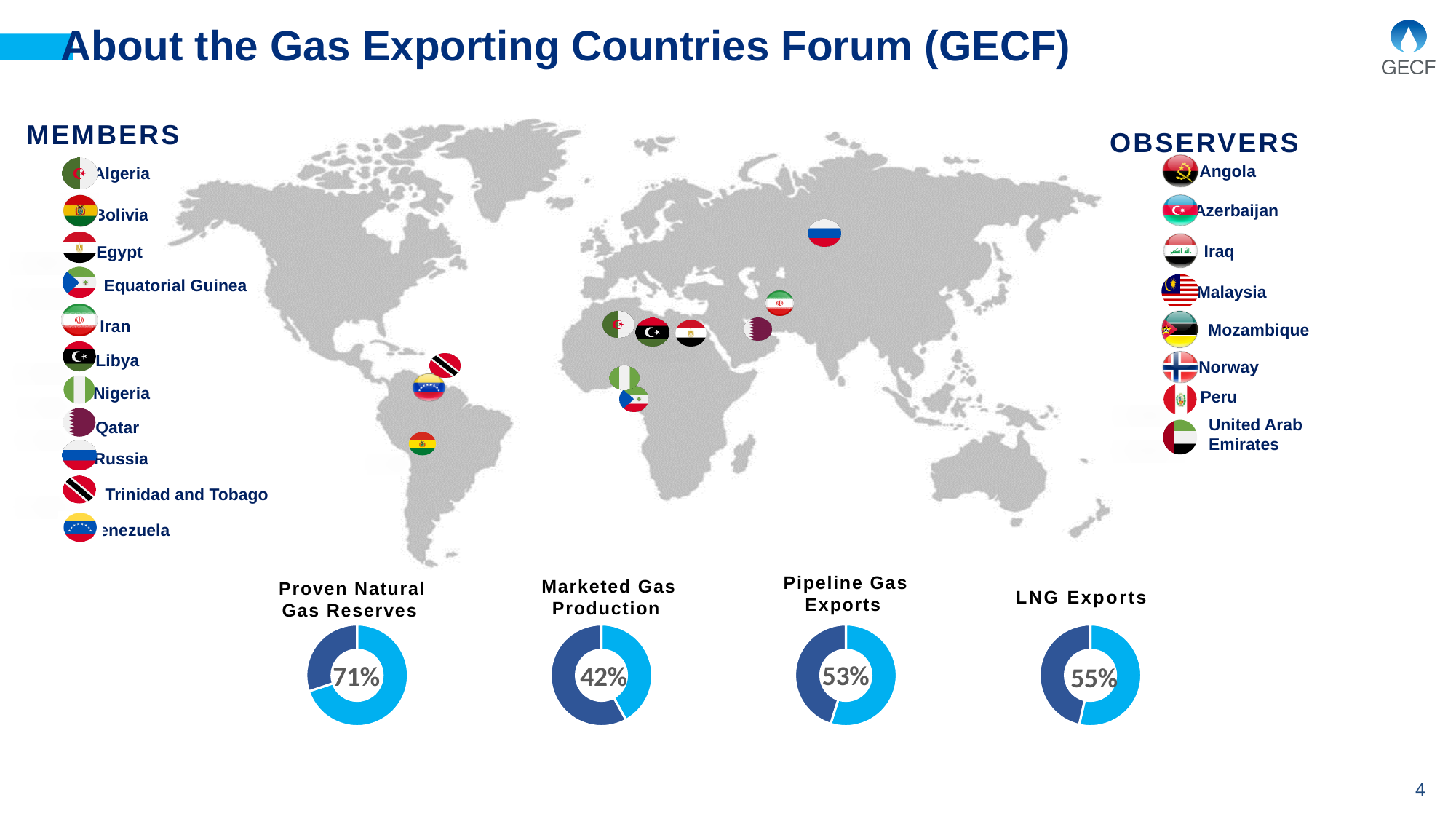
Which is larger, the LNG Exports percentage or the Pipeline Gas Exports percentage? LNG Exports How many donut charts are shown at the bottom of the slide? 4 Which of the four donut charts at the bottom of the slide shows the highest percentage? Proven Natural Gas Reserves What is the difference in percentage points between the Proven Natural Gas Reserves value and the Marketed Gas Production value? 29 percentage points What value is shown in the Proven Natural Gas Reserves donut chart? 71% What value is shown in the Pipeline Gas Exports donut chart? 53% Which of the four donut charts at the bottom of the slide shows the lowest percentage? Marketed Gas Production Is the value in the Marketed Gas Production chart greater or less than 50%? less In the Proven Natural Gas Reserves chart, what share of the donut is not covered by the 71% slice? 29% What kind of chart is used to show the Proven Natural Gas Reserves value? Donut (pie) chart What value is shown in the LNG Exports donut chart? 55% What value is shown in the Marketed Gas Production donut chart? 42%